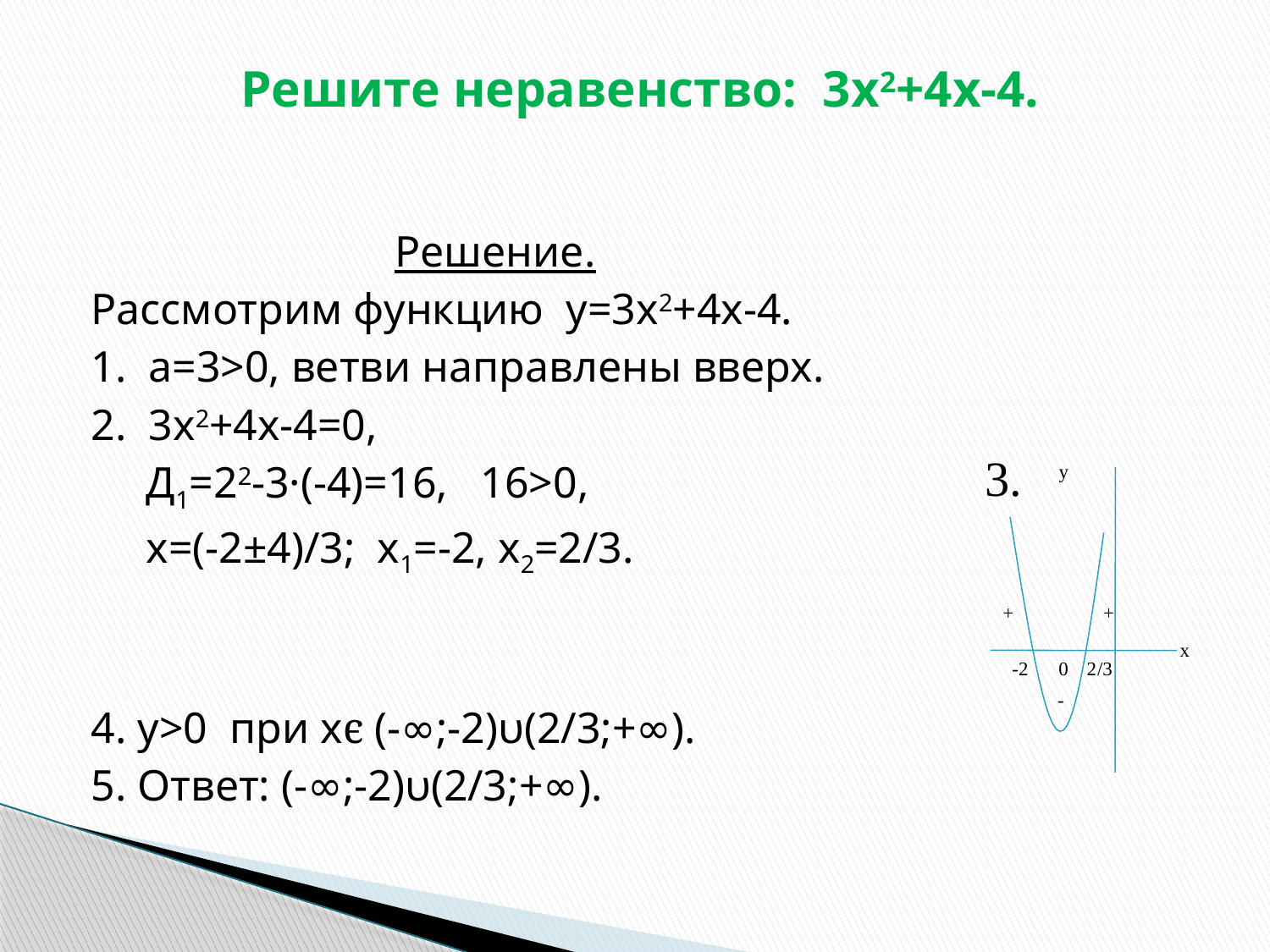
How many x-intercepts are marked on the parabola sketch? 2 Which labeled x-intercept of the parabola is larger, -2 or 2/3? 2/3 What sign is marked on the sketch to the left of x = -2? + Do the branches of the parabola in the sketch open upward or downward? upward What x-values are labeled where the parabola crosses the x-axis in the sketch? -2 and 2/3 What sign is marked on the sketch between the x-intercepts -2 and 2/3? -